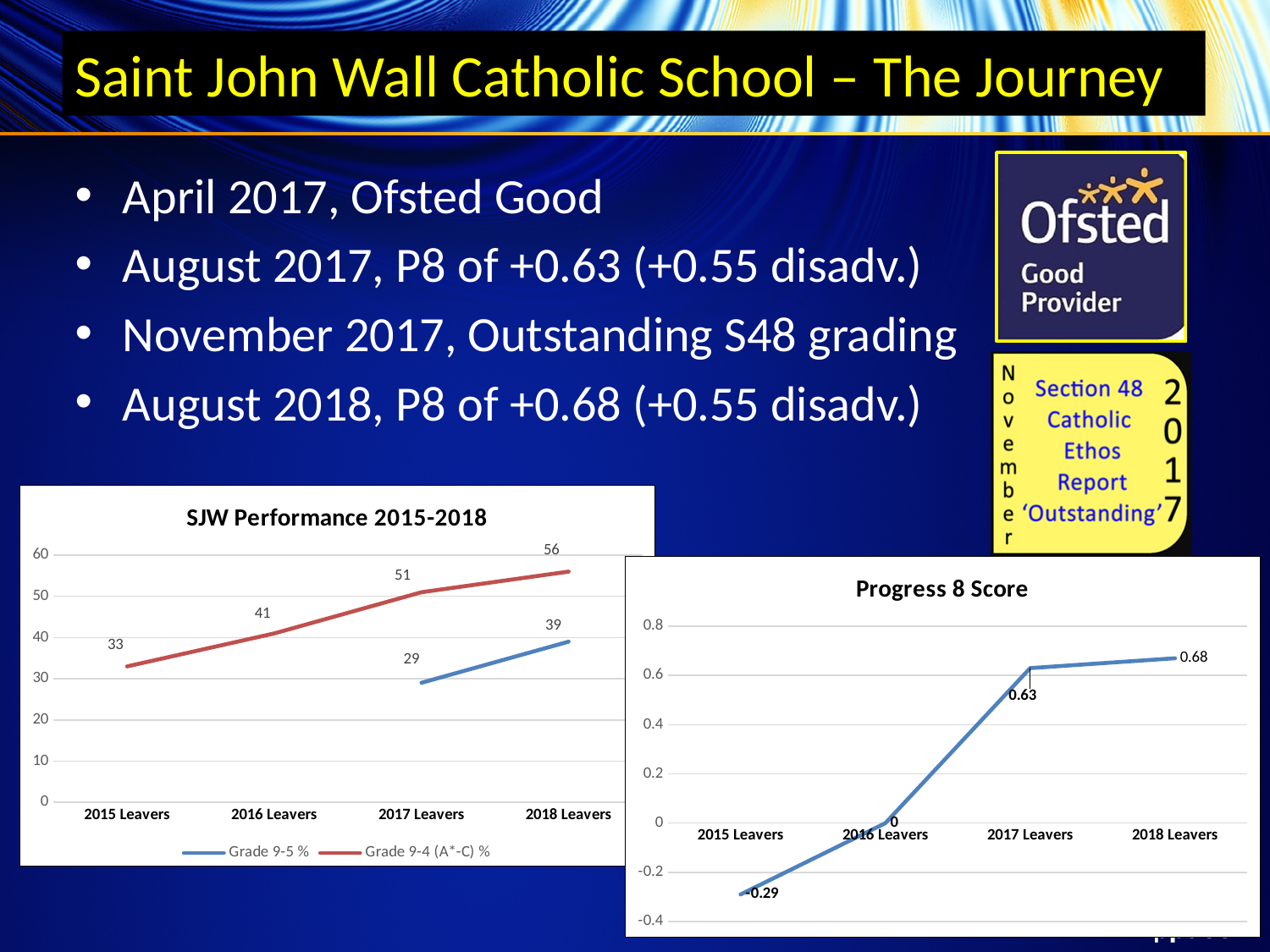
In the 'Progress 8 Score' chart, what is the value for 2015 Leavers? -0.29 In the 'Progress 8 Score' chart, how many year groups are plotted on the x axis? 4 In the 'Progress 8 Score' chart, what is the value for 2017 Leavers? 0.63 In the 'SJW Performance 2015-2018' chart, what is the Grade 9-4 (A*-C) % value for 2016 Leavers? 41 In the 'SJW Performance 2015-2018' chart, which year group has the highest Grade 9-4 (A*-C) % value? 2018 Leavers In the 'SJW Performance 2015-2018' chart, what is the Grade 9-5 % value for 2018 Leavers? 39 In the 'SJW Performance 2015-2018' chart, how many series does the legend list? 2 In the 'Progress 8 Score' chart, which year group has the lowest value? 2015 Leavers In the 'SJW Performance 2015-2018' chart, does the Grade 9-4 (A*-C) % series rise or fall from 2015 Leavers to 2018 Leavers? rise In the 'SJW Performance 2015-2018' chart, what is the difference between the Grade 9-4 (A*-C) % and Grade 9-5 % values for 2017 Leavers? 22 What kind of chart is the 'Progress 8 Score' chart? line chart In the 'SJW Performance 2015-2018' chart, what is the difference between the Grade 9-4 (A*-C) % values for 2018 Leavers and 2015 Leavers? 23